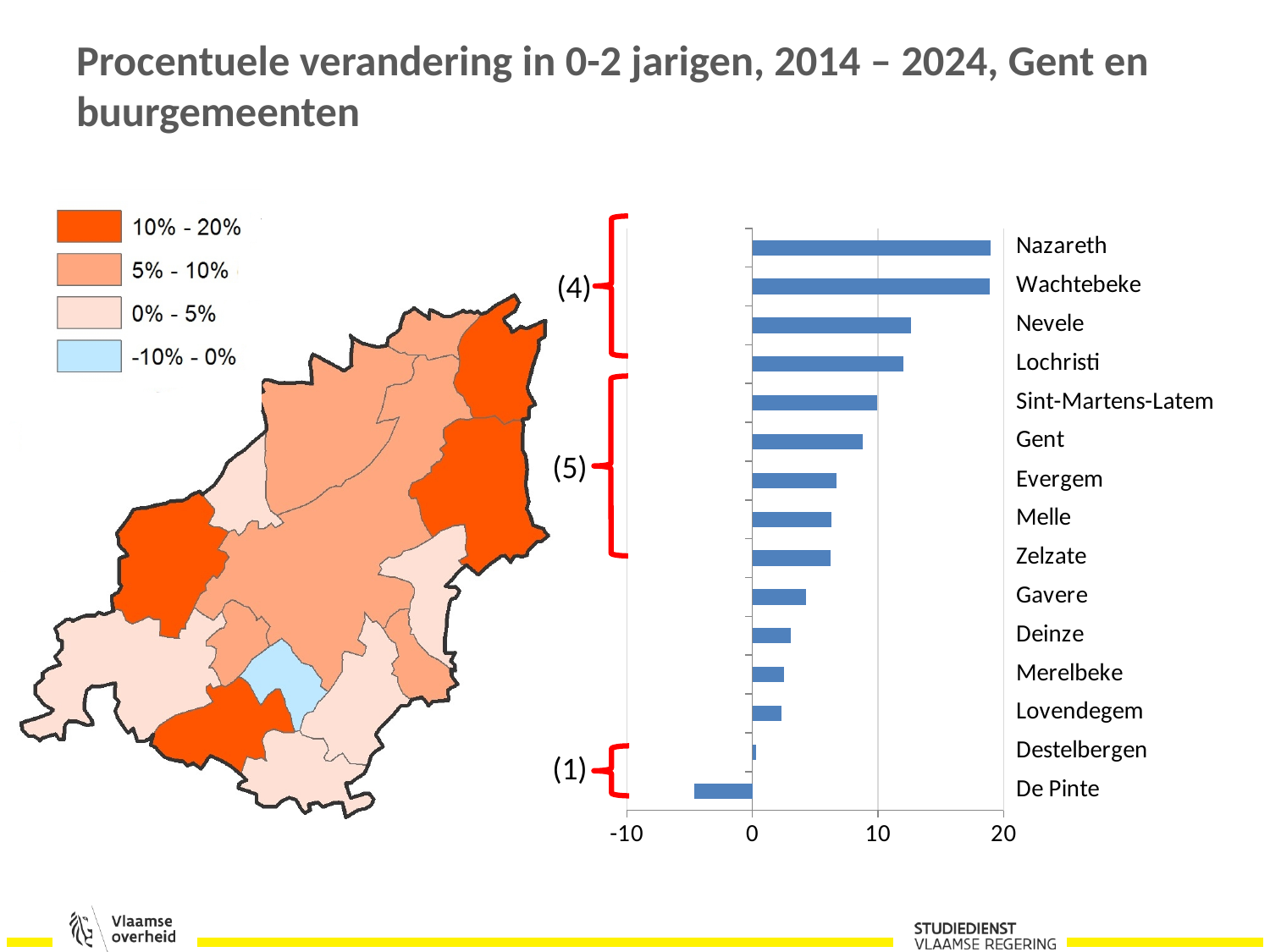
Is the value for Lochristi greater or less than 10? greater Is the value for Gavere greater or less than 10? less Is the value for De Pinte greater or less than 0? less Which has the larger value, Gavere or Deinze? Gavere Which municipality has the lowest value in the bar chart? De Pinte What is the title of the slide? Procentuele verandering in 0-2 jarigen, 2014 – 2024, Gent en buurgemeenten Do the bar values increase or decrease going from the top municipality (Nazareth) to the bottom (De Pinte)? decrease How many municipalities are listed in the bar chart? 15 Which has the larger value, Nazareth or Gent? Nazareth What kind of chart is shown on the right side of the slide? bar chart